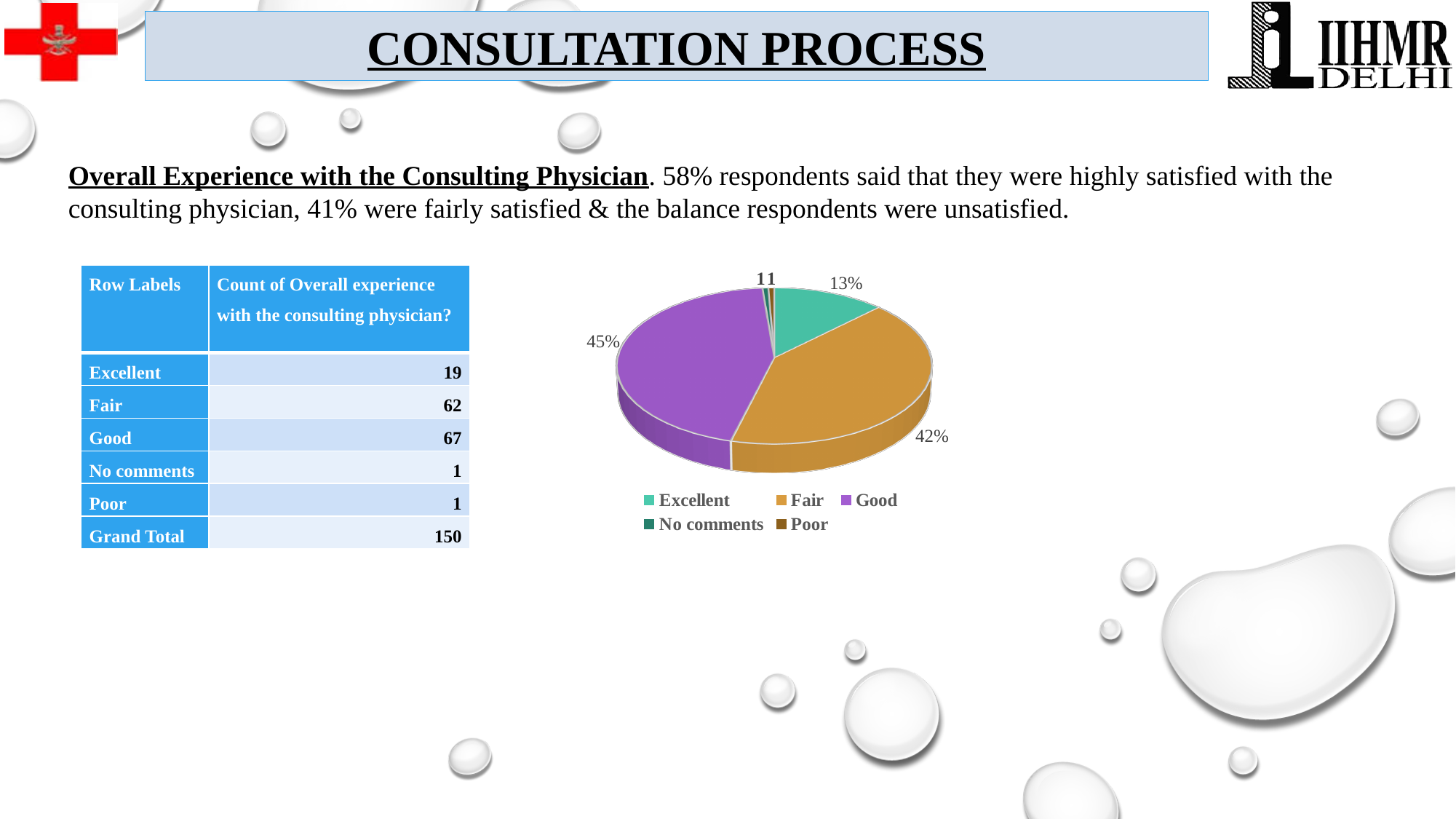
What is the difference in percentage points between the Good slice and the Fair slice? 3% What share of the pie does the Excellent slice represent? 13% What is the difference in percentage points between the Fair slice and the Excellent slice? 29% What share of the pie does the Good slice represent? 45% Which slice is larger, Fair or Excellent? Fair What share of the pie does the Fair slice represent? 42% Which colour represents the Excellent category in the pie chart? teal green What kind of chart is shown on the slide? pie chart Which category has the largest slice of the pie? Good How many categories does the legend of the pie chart list? 5 Which slice is larger, Good or Fair? Good Which colour represents the Good category in the pie chart? purple